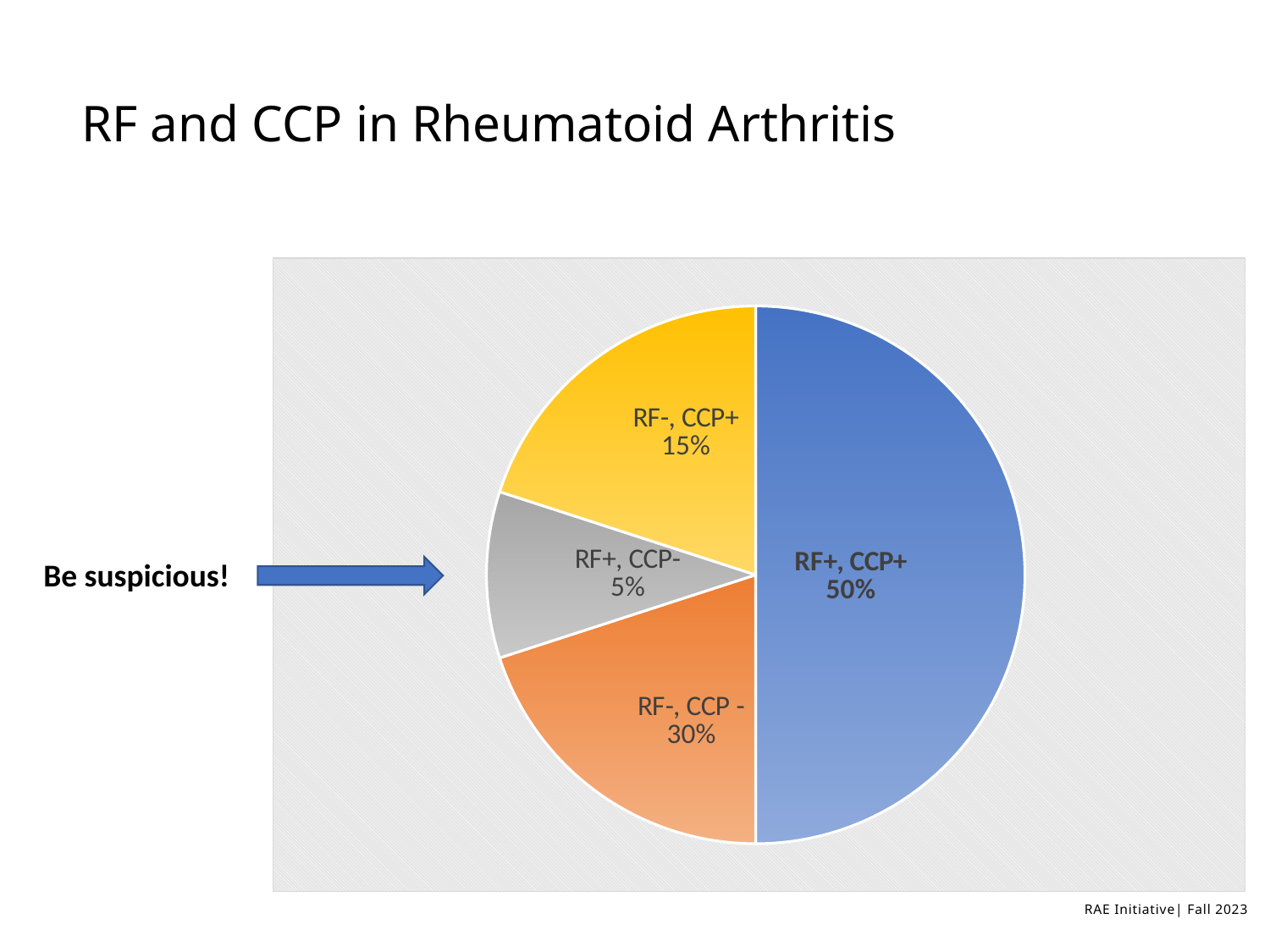
Which slice does the arrow labelled "Be suspicious!" point toward? RF+, CCP- What percentage of the pie is RF-, CCP+? 15% What percentage of the pie is RF+, CCP+? 50% What percentage of the pie is RF+, CCP-? 5% What kind of chart is shown on the slide? pie chart Which slice of the pie is the largest? RF+, CCP+ Which is larger, the RF-, CCP+ slice or the RF+, CCP- slice? RF-, CCP+ How many slices does the pie chart have? 4 What percentage of the pie is RF-, CCP -? 30% Which slice of the pie is the smallest? RF+, CCP- What is the difference in percentage points between the RF+, CCP+ slice and the RF-, CCP - slice? 20 What is the title of the slide containing the pie chart? RF and CCP in Rheumatoid Arthritis